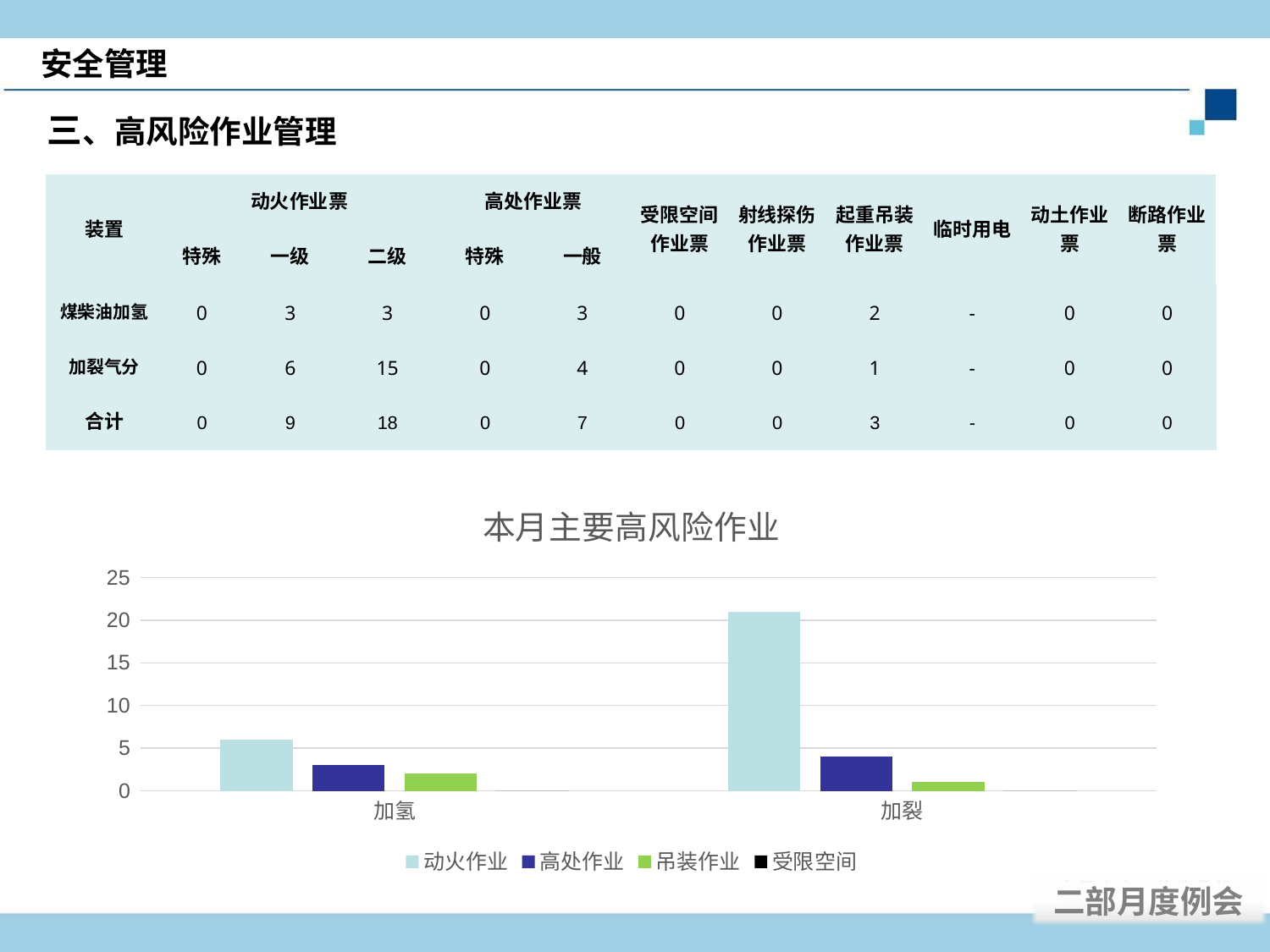
How many categories are shown on the x axis of the 本月主要高风险作业 chart? 2 How many series does the legend of the 本月主要高风险作业 chart list? 4 In the 本月主要高风险作业 chart, is the value of 动火作业 for 加氢 greater or less than 10? less What kind of chart is shown under the title 本月主要高风险作业? bar chart In the 本月主要高风险作业 chart, is the value of 动火作业 for 加裂 greater or less than 20? greater In the 本月主要高风险作业 chart, which category has the higher 动火作业 value, 加氢 or 加裂? 加裂 In the 本月主要高风险作业 chart, is the value of 吊装作业 for 加氢 greater or less than 5? less In the 本月主要高风险作业 chart, which series has the shortest visible bar for 加氢? 吊装作业 In the 本月主要高风险作业 chart, which series has the tallest bar for 加裂? 动火作业 In the 本月主要高风险作业 chart, which category has the higher 吊装作业 value, 加氢 or 加裂? 加氢 What is the title of the chart on the slide? 本月主要高风险作业